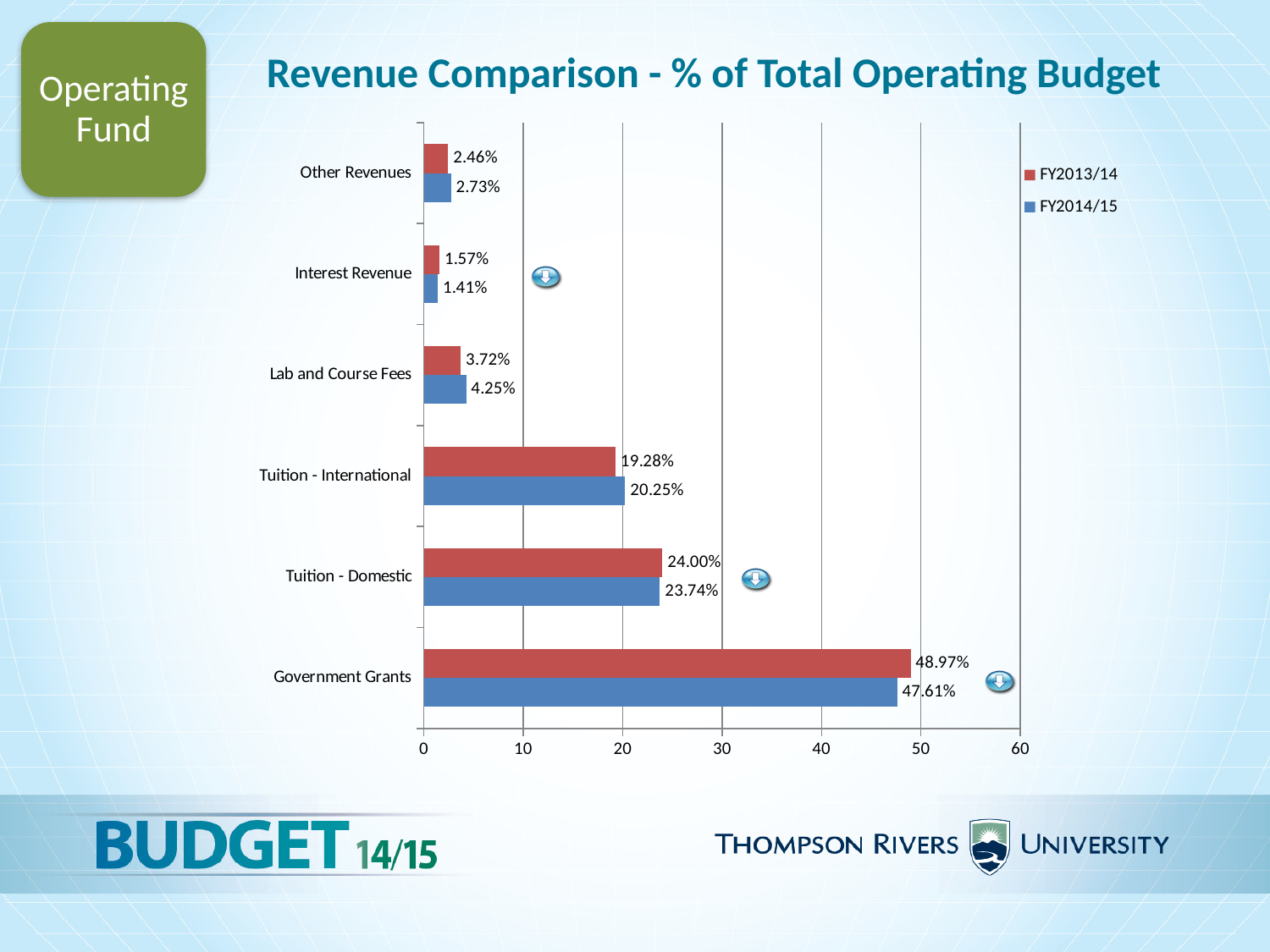
What kind of chart is shown on the slide? Bar chart What is the title of the chart? Revenue Comparison - % of Total Operating Budget What is the FY2013/14 value for Tuition - International? 19.28% What is the FY2014/15 value for Government Grants? 47.61% What is the FY2014/15 value for Lab and Course Fees? 4.25% Which category has the highest FY2013/14 value? Government Grants How many series does the legend list? 2 What is the difference between the FY2013/14 and FY2014/15 values for Government Grants? 1.36% Which is larger for Tuition - Domestic, the FY2013/14 value or the FY2014/15 value? FY2013/14 Which colour represents FY2014/15 in the legend? Blue Which category has the lowest FY2014/15 value? Interest Revenue How many categories are shown on the chart? 6